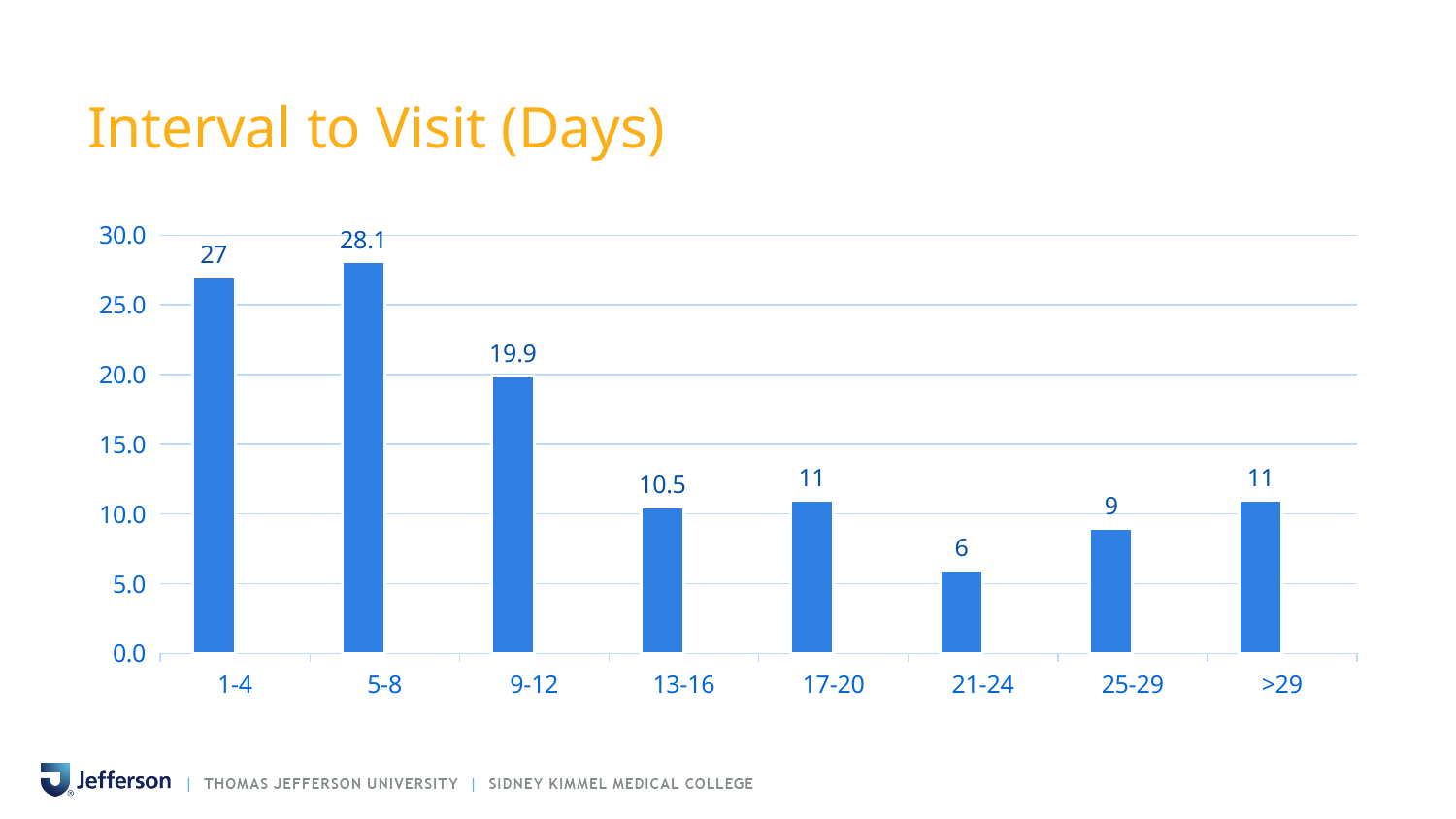
What is the title of the chart? Interval to Visit (Days) Which interval has the highest value? 5-8 What is the value for the 9-12 day interval? 19.9 What is the value for the >29 day interval? 11 Which is larger, the value for 13-16 or the value for 25-29? 13-16 What kind of chart is shown on the slide? Bar chart What is the value for the 21-24 day interval? 6 Is the value for the 17-20 interval greater or less than 10.0? greater How many interval categories are shown on the x axis? 8 Which interval has the lowest value? 21-24 What is the value for the 1-4 day interval? 27 What is the difference between the values for the 5-8 and 9-12 intervals? 8.2